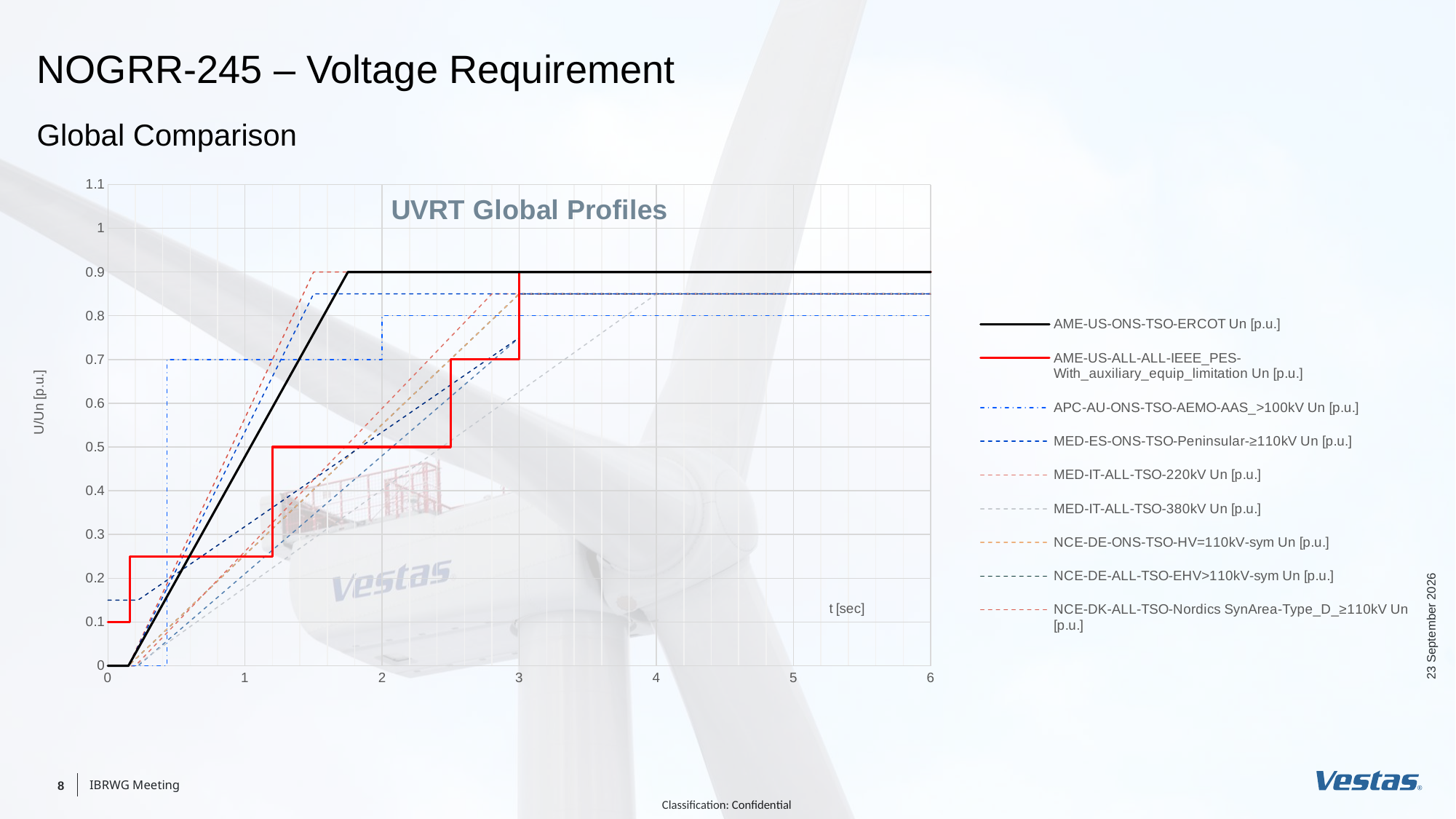
Is the value of the AME-US-ONS-TSO-ERCOT series at t = 1.5 sec greater or less than 0.6? greater Does the AME-US-ONS-TSO-ERCOT series rise or fall between t = 0 and t = 1.5 sec? rise What kind of chart is shown on the slide? line chart What is the value of the AME-US-ALL-ALL-IEEE_PES-With_auxiliary_equip_limitation series at t = 2 sec? 0.5 How many series does the legend of the UVRT Global Profiles chart list? 9 Is the value of the AME-US-ALL-ALL-IEEE_PES-With_auxiliary_equip_limitation series at t = 0.5 sec greater or less than 0.3? less What is the value of the AME-US-ALL-ALL-IEEE_PES-With_auxiliary_equip_limitation series at t = 5 sec? 0.9 What is the title of the chart? UVRT Global Profiles What is the value of the APC-AU-ONS-TSO-AEMO-AAS_>100kV series at t = 1 sec? 0.7 What is the value of the AME-US-ONS-TSO-ERCOT series at t = 4 sec? 0.9 What is the label of the y axis of the chart? U/Un [p.u.] At t = 1 sec, which is larger: the AME-US-ONS-TSO-ERCOT value or the AME-US-ALL-ALL-IEEE_PES-With_auxiliary_equip_limitation value? AME-US-ONS-TSO-ERCOT